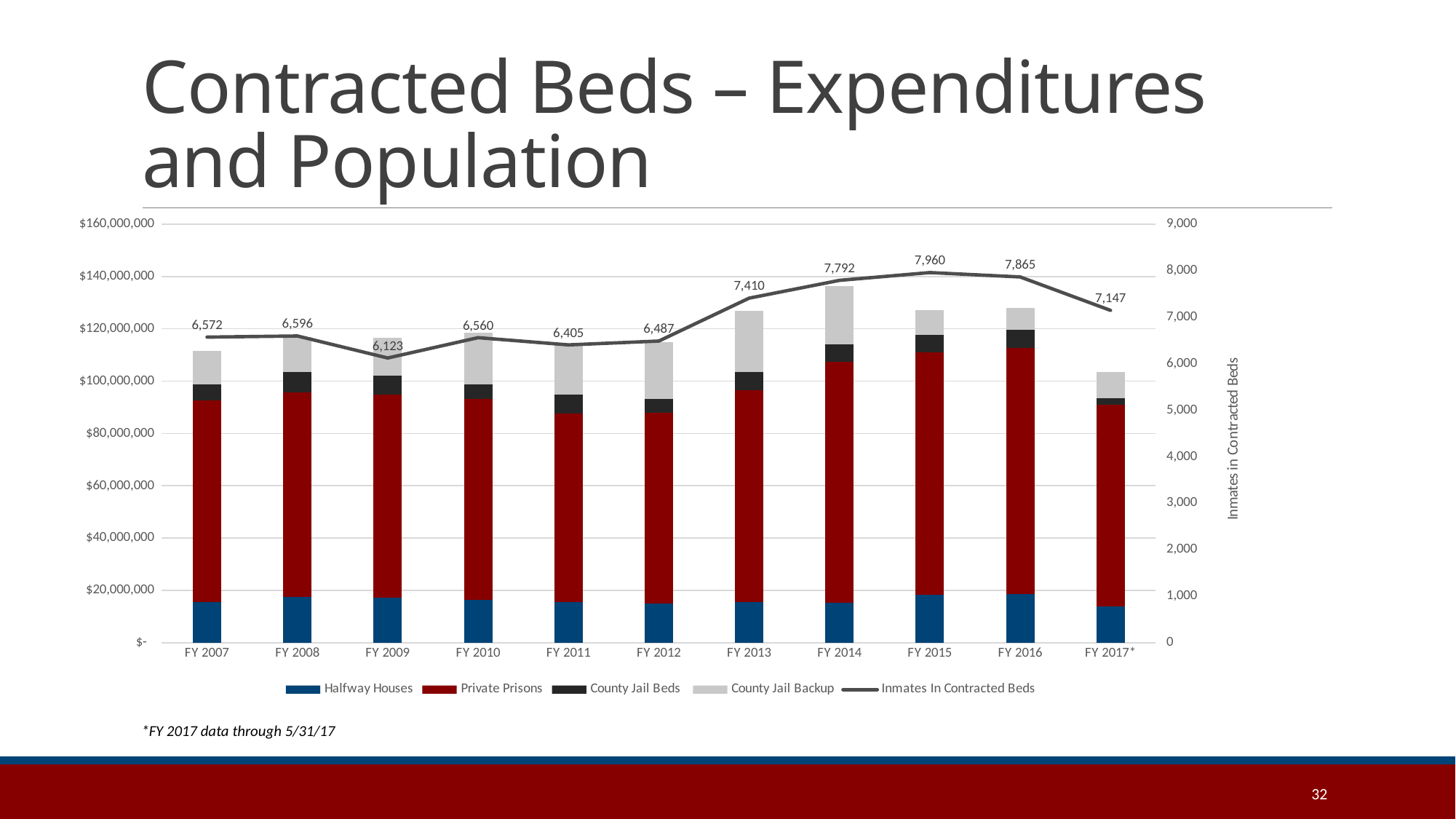
How many fiscal years are shown on the x axis? 11 What is the value of Inmates In Contracted Beds for FY 2017*? 7,147 Is the total expenditure bar for FY 2017* greater or less than $120,000,000? less In which fiscal year is the Inmates In Contracted Beds line highest? FY 2015 What is the value of Inmates In Contracted Beds for FY 2015? 7,960 Does the Inmates In Contracted Beds line rise or fall from FY 2012 to FY 2015? rise What is the difference between the Inmates In Contracted Beds values for FY 2015 and FY 2009? 1,837 Is the total expenditure bar for FY 2014 greater or less than $120,000,000? greater Which is larger, the Inmates In Contracted Beds value for FY 2014 or for FY 2016? FY 2016 What is the value of Inmates In Contracted Beds for FY 2009? 6,123 In which fiscal year is the Inmates In Contracted Beds line lowest? FY 2009 How many series does the legend list? 5